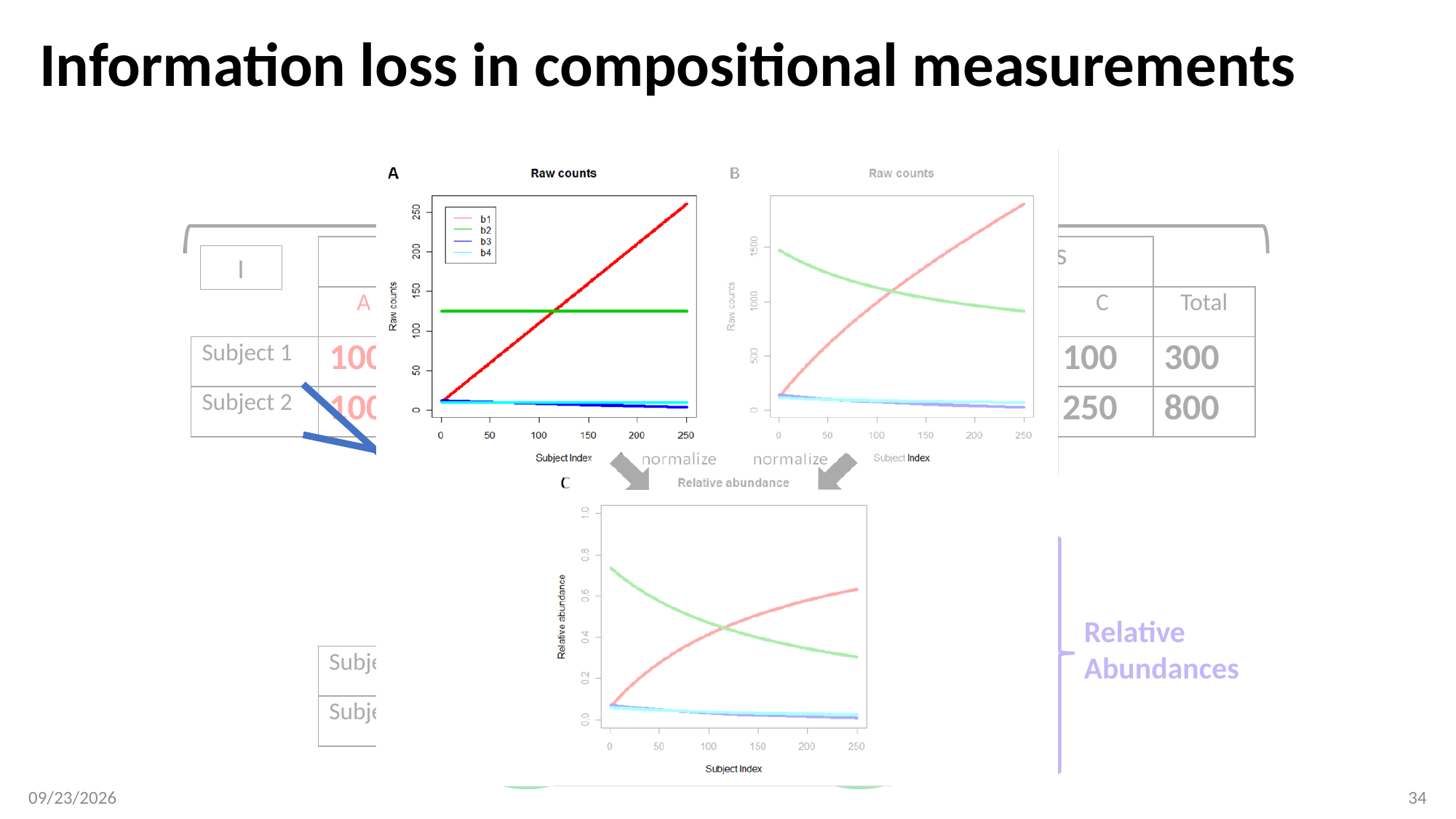
In chart B (Raw counts, right), does the green series rise or fall as the subject index increases? fall In chart A (Raw counts, left), does the b1 series rise or fall as the subject index increases? rise What kind of chart is chart A (Raw counts, left)? line chart In chart C (Relative abundance, bottom), is the value of the green series at subject index 0 greater or less than 0.6? greater In chart A (Raw counts, left), is the value of b1 at subject index 250 greater or less than 200? greater In chart A (Raw counts, left), how many series does the legend list? 4 In chart B (Raw counts, right), is the value of the red series at subject index 250 greater or less than 1500? greater In chart A (Raw counts, left), which series has the highest value at subject index 250? b1 In chart A (Raw counts, left), which series has the highest value at subject index 0? b2 What is the y-axis label of chart C (bottom)? Relative abundance In chart A (Raw counts, left), what are the names of the series in the legend? b1, b2, b3, b4